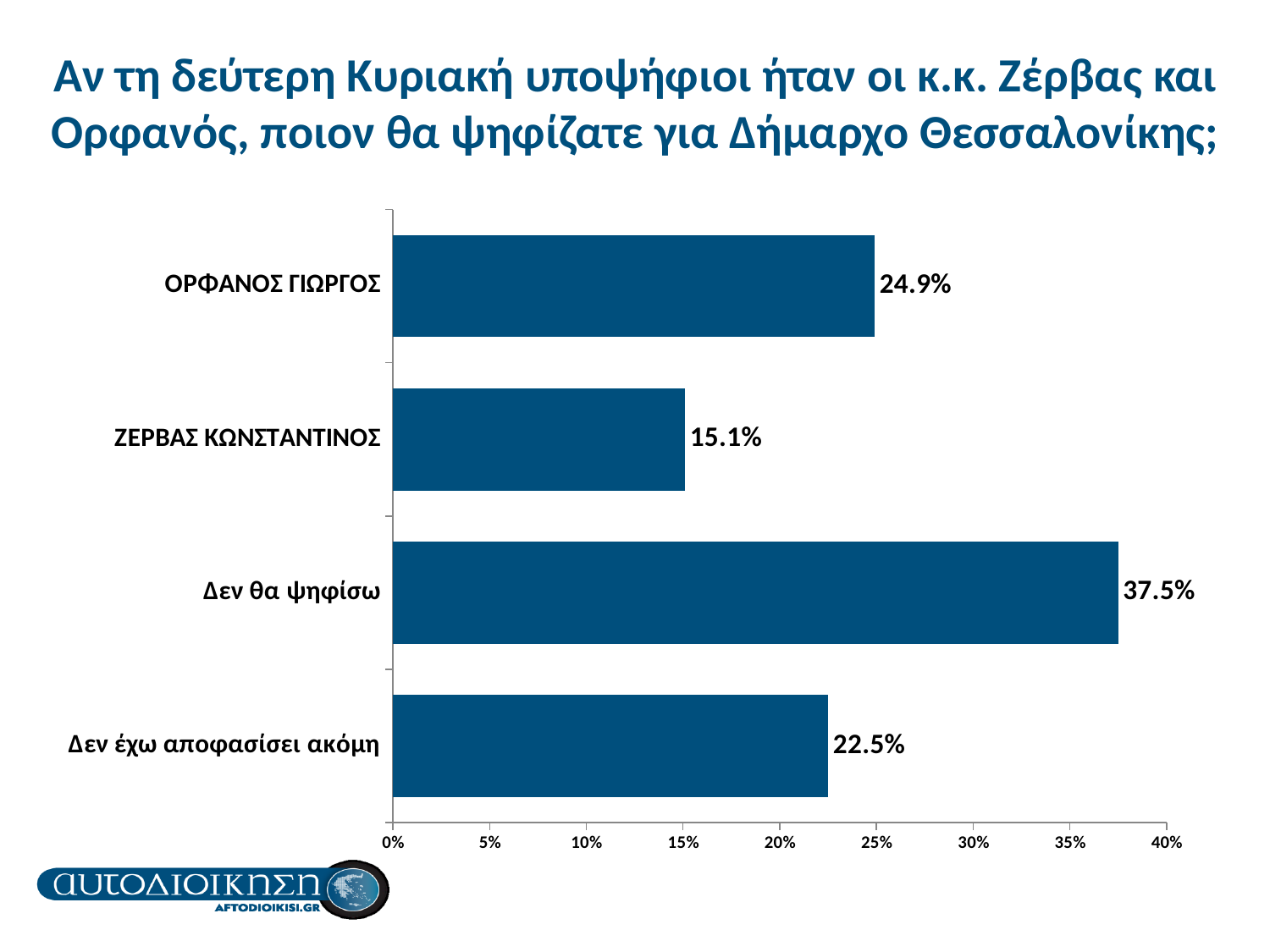
What is the value for Δεν έχω αποφασίσει ακόμη? 22.5% Which category has the lowest value? ΖΕΡΒΑΣ ΚΩΝΣΤΑΝΤΙΝΟΣ What is the value for Δεν θα ψηφίσω? 37.5% What kind of chart is shown on the slide? bar chart Which is larger, the value for ΟΡΦΑΝΟΣ ΓΙΩΡΓΟΣ or the value for Δεν έχω αποφασίσει ακόμη? ΟΡΦΑΝΟΣ ΓΙΩΡΓΟΣ How many categories are shown in the chart? 4 What is the value for ΟΡΦΑΝΟΣ ΓΙΩΡΓΟΣ? 24.9% What is the maximum value shown on the horizontal axis? 40% Is the value for Δεν θα ψηφίσω greater or less than 35%? greater What is the value for ΖΕΡΒΑΣ ΚΩΝΣΤΑΝΤΙΝΟΣ? 15.1% What is the difference between the values for ΟΡΦΑΝΟΣ ΓΙΩΡΓΟΣ and ΖΕΡΒΑΣ ΚΩΝΣΤΑΝΤΙΝΟΣ? 9.8% Which category has the highest value? Δεν θα ψηφίσω